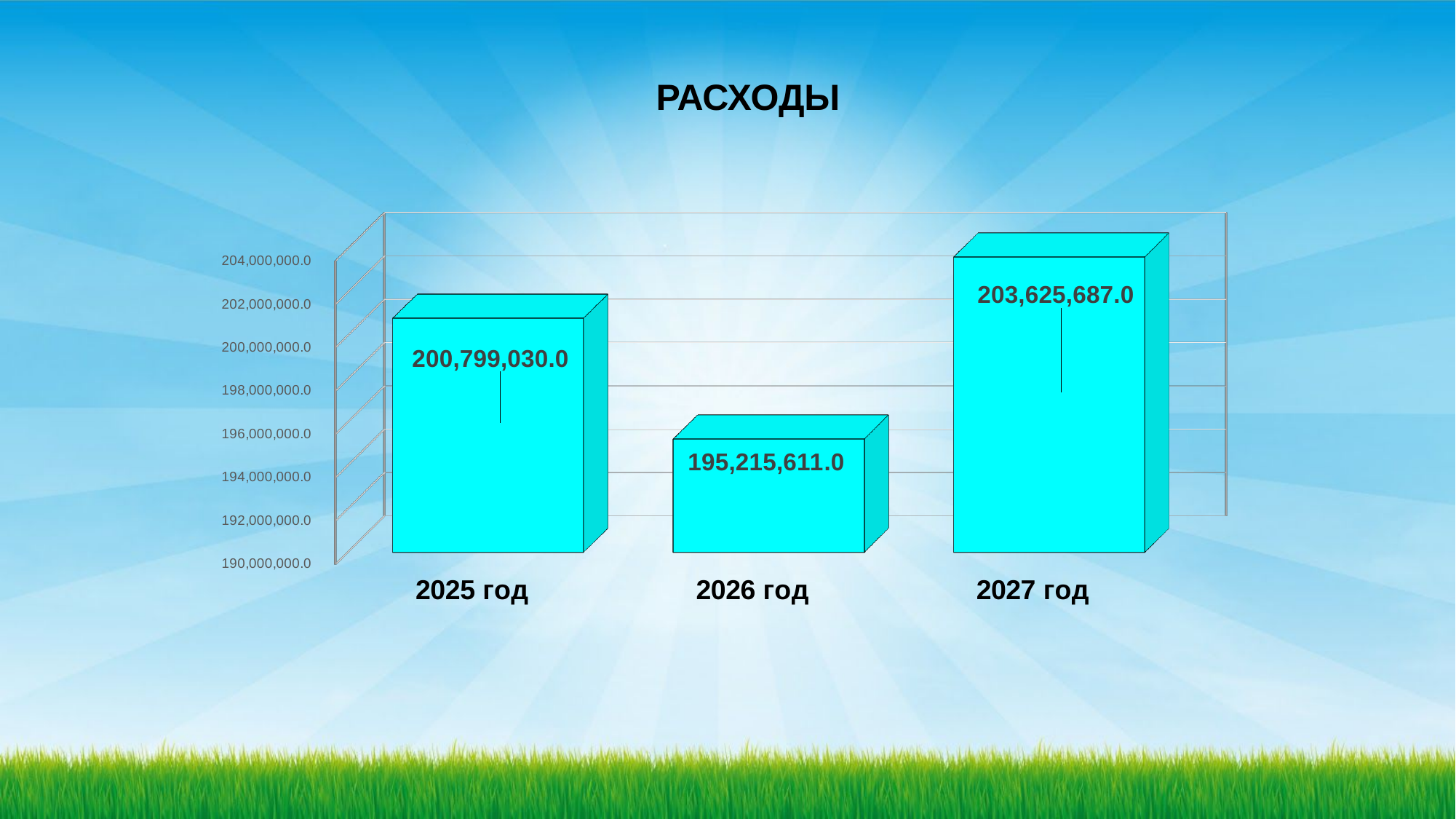
Which year has the highest value? 2027 год How many years are shown on the chart? 3 What is the difference between the values for 2027 год and 2025 год? 2,826,657.0 Which is larger, the value for 2025 год or the value for 2026 год? 2025 год What is the difference between the values for 2025 год and 2026 год? 5,583,419.0 What is the value for 2027 год? 203,625,687.0 What is the title of the chart? РАСХОДЫ Which year has the lowest value? 2026 год Is the value for 2026 год greater or less than 196,000,000.0? less What is the value for 2026 год? 195,215,611.0 What is the value for 2025 год? 200,799,030.0 What kind of chart is shown on the slide? bar chart